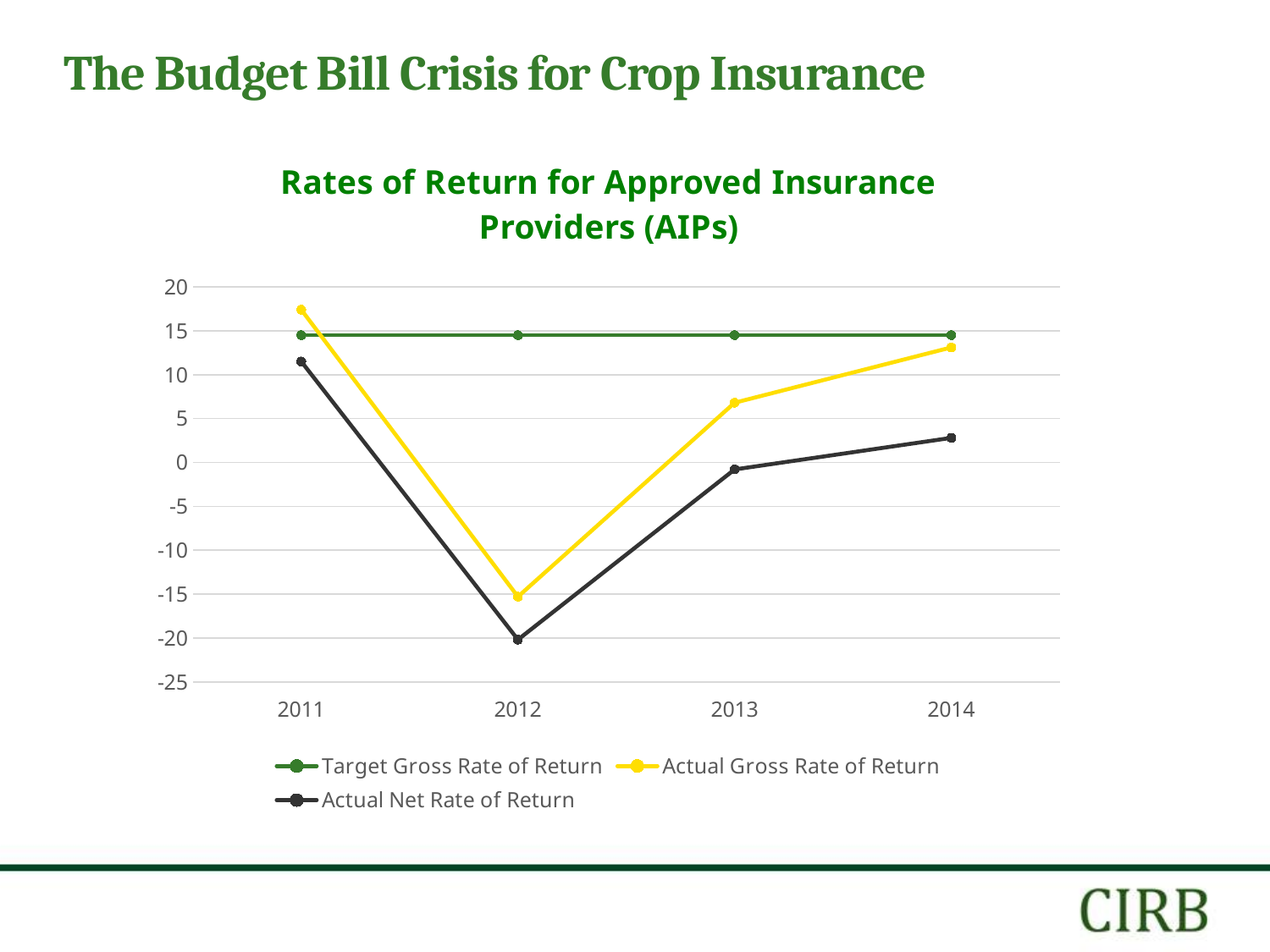
In which year is the Actual Gross Rate of Return lowest? 2012 In which year is the Actual Net Rate of Return highest? 2011 Does the Actual Gross Rate of Return rise or fall from 2012 to 2014? rise Is the Actual Gross Rate of Return for 2012 greater or less than -10? less What kind of chart is shown on the slide? line chart What is the title of the chart? Rates of Return for Approved Insurance Providers (AIPs) How many series does the legend list? 3 Is the Actual Net Rate of Return for 2014 greater or less than 0? greater How many years are shown on the x axis? 4 Is the Actual Net Rate of Return for 2012 greater or less than -15? less In 2011, which is larger: the Actual Gross Rate of Return or the Target Gross Rate of Return? Actual Gross Rate of Return